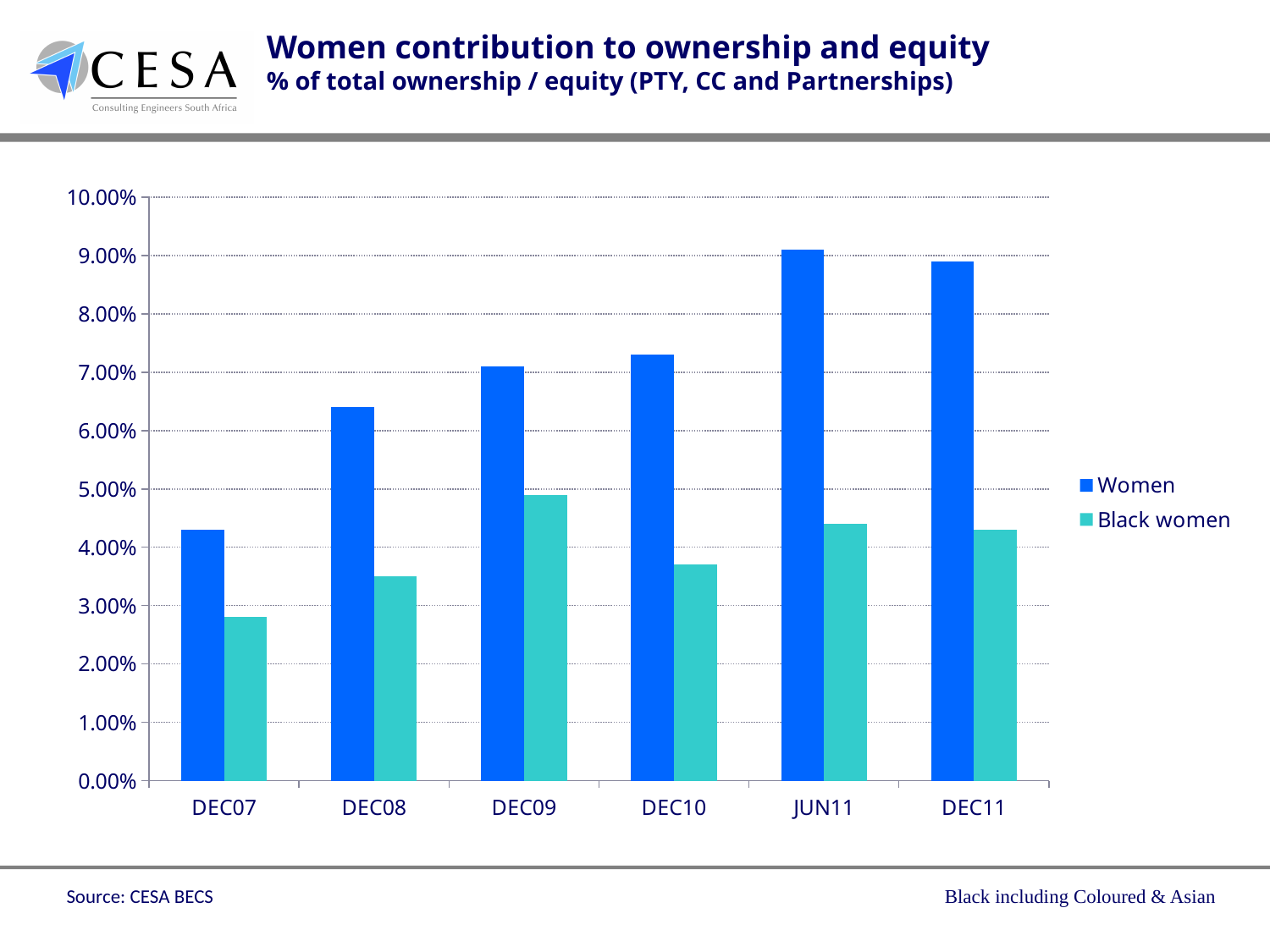
How many time periods are shown on the x axis of the chart? 6 How many series does the chart legend list? 2 In which period is the Black women series highest? DEC09 Is the value for Black women in DEC07 greater or less than 3.00%? less Which colour represents the Black women series in the chart? Teal (light blue-green) Is the value for Women in DEC08 greater or less than 6.00%? greater In which period is the Women series lowest? DEC07 What kind of chart is shown on the slide? Bar chart Which is larger: the Black women value in DEC09 or in JUN11? DEC09 In which period is the Women series highest? JUN11 In which period is the Black women series lowest? DEC07